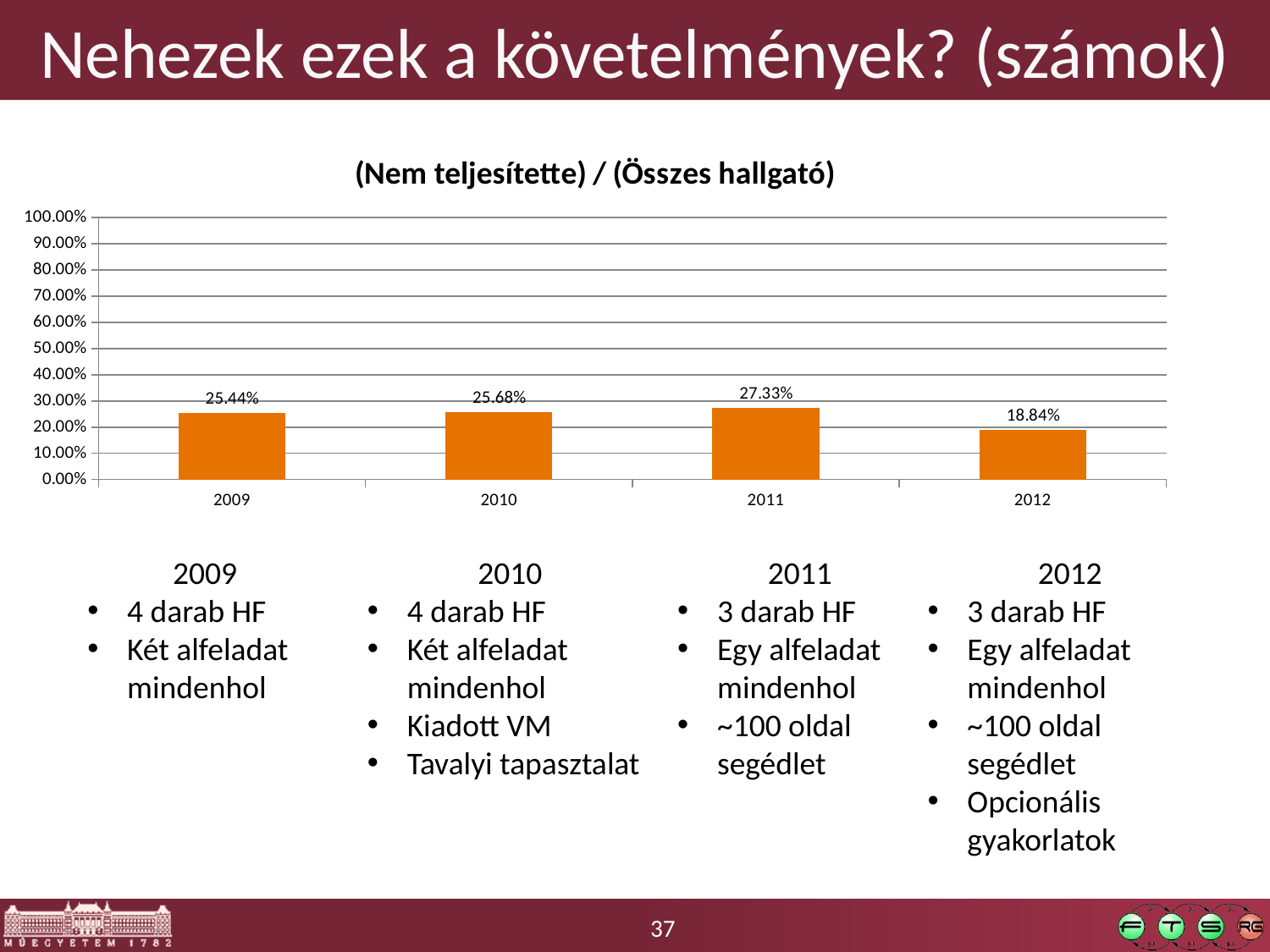
What is the value for 2012? 18.84% What is the value for 2009? 25.44% What is the value for 2011? 27.33% What is the difference between the values for 2011 and 2012? 8.49% How many years are shown on the x axis? 4 What is the title of the chart? (Nem teljesítette) / (Összes hallgató) Is the value for 2012 greater or less than 20.00%? less Which year has the lowest value? 2012 Which year has the highest value? 2011 Which is larger, the value for 2011 or the value for 2009? 2011 What is the highest value shown on the y axis? 100.00% What kind of chart is shown? bar chart